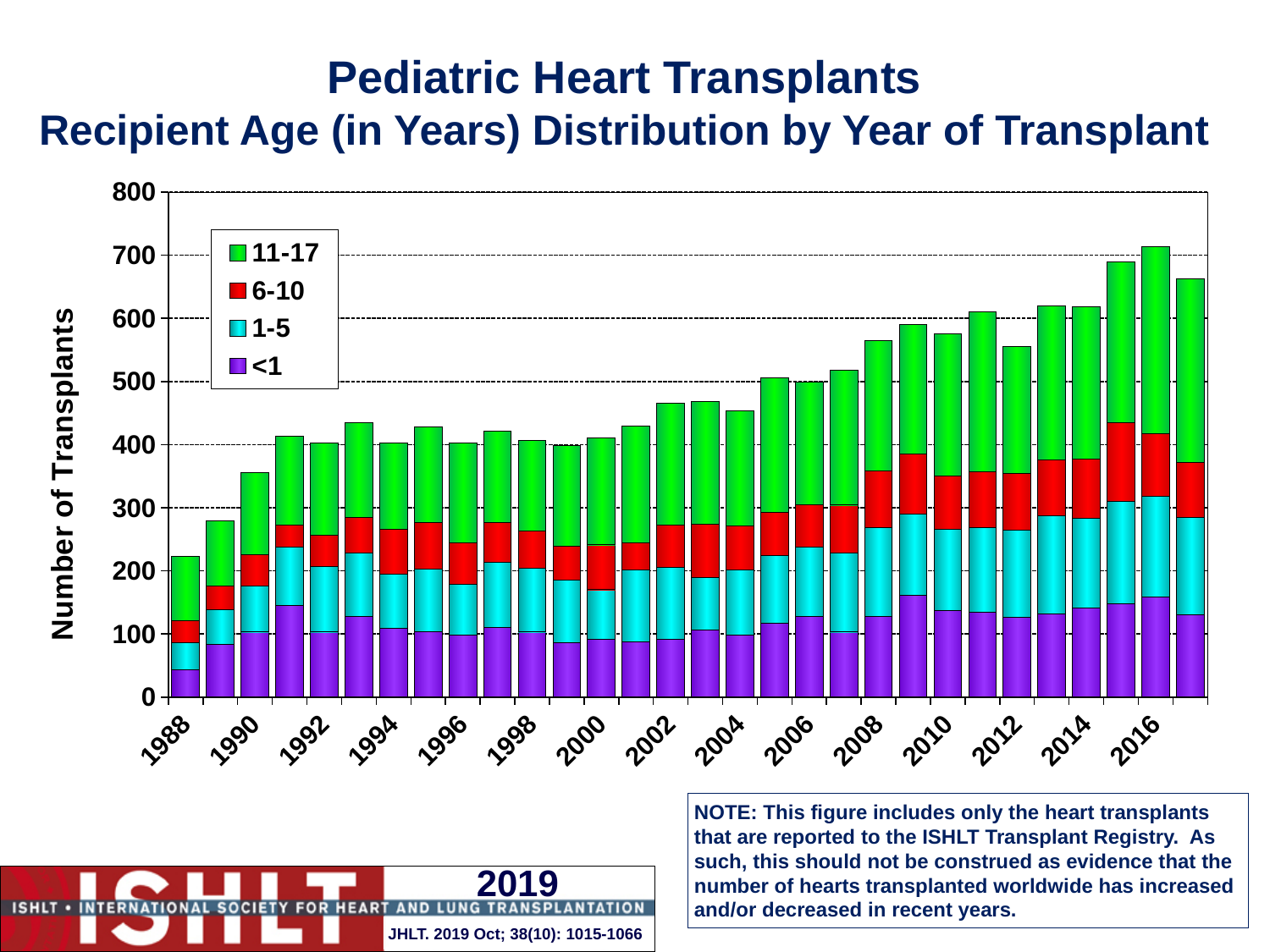
What are the four age groups listed in the legend? 11-17, 6-10, 1-5, <1 What is the title of the y axis? Number of Transplants Is the total number of transplants in 2016 greater or less than 700? greater How many series does the legend list? 4 Overall, does the total number of transplants rise or fall from 1988 to 2017? rise Is the total number of transplants in 2000 greater or less than 500? less What kind of chart is shown on the slide? stacked bar chart Is the total number of transplants in 2009 greater or less than 500? greater Which year has the highest total number of transplants? 2016 Which year has the lowest total number of transplants? 1988 Which year has a larger total number of transplants, 2005 or 2009? 2009